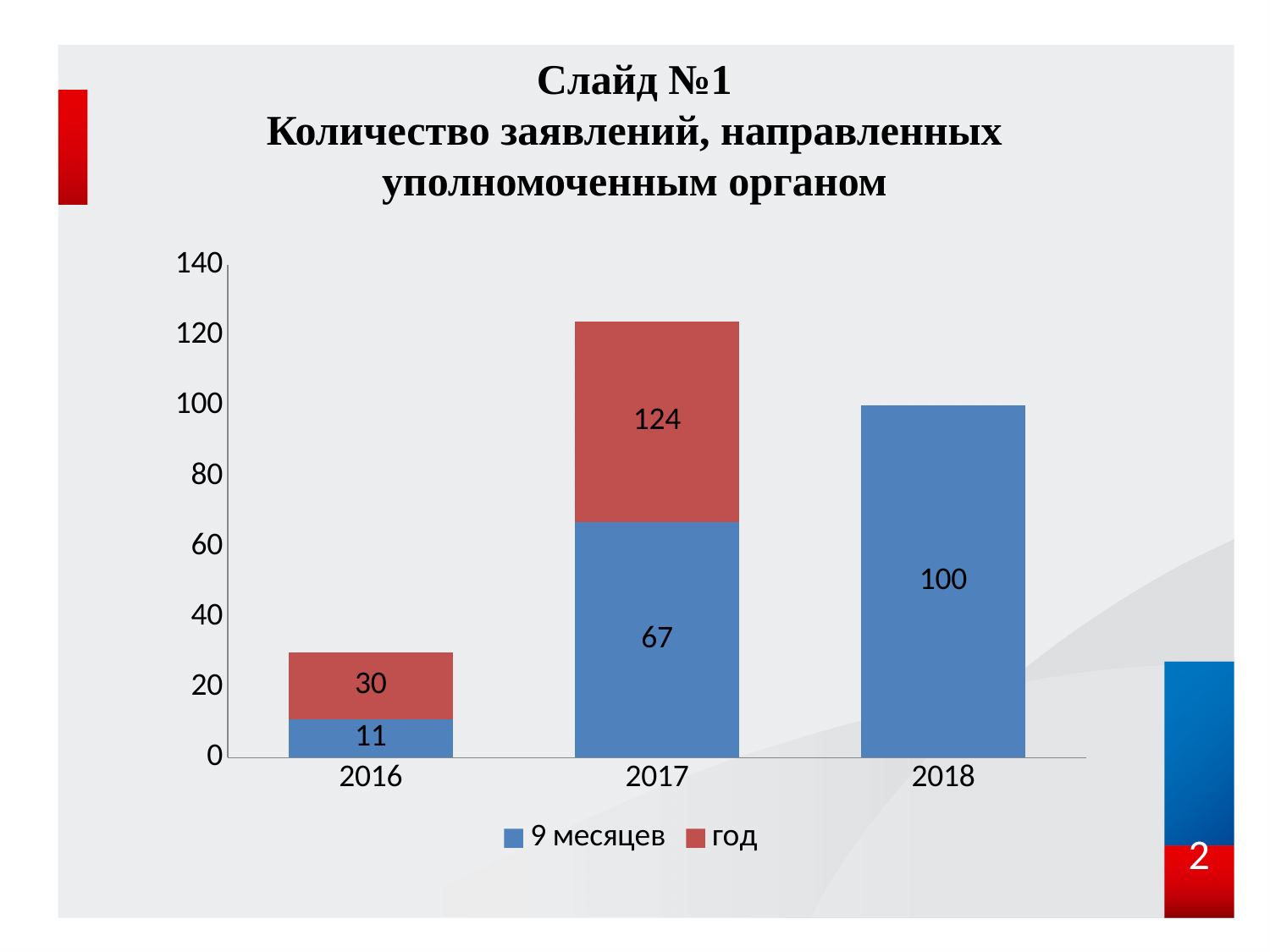
What value is labelled for "год" in 2016? 30 Do the "9 месяцев" values rise or fall from 2016 to 2018? rise What is the value for "9 месяцев" in 2016? 11 Which year has the highest value for "9 месяцев"? 2018 Which year has the lowest value for "9 месяцев"? 2016 What value is labelled for "год" in 2017? 124 What is the value for "9 месяцев" in 2018? 100 How many years are shown on the x axis of the chart? 3 What kind of chart is shown on the slide? bar chart What is the difference between the "9 месяцев" values for 2017 and 2016? 56 How many series does the chart legend list? 2 What is the value for "9 месяцев" in 2017? 67